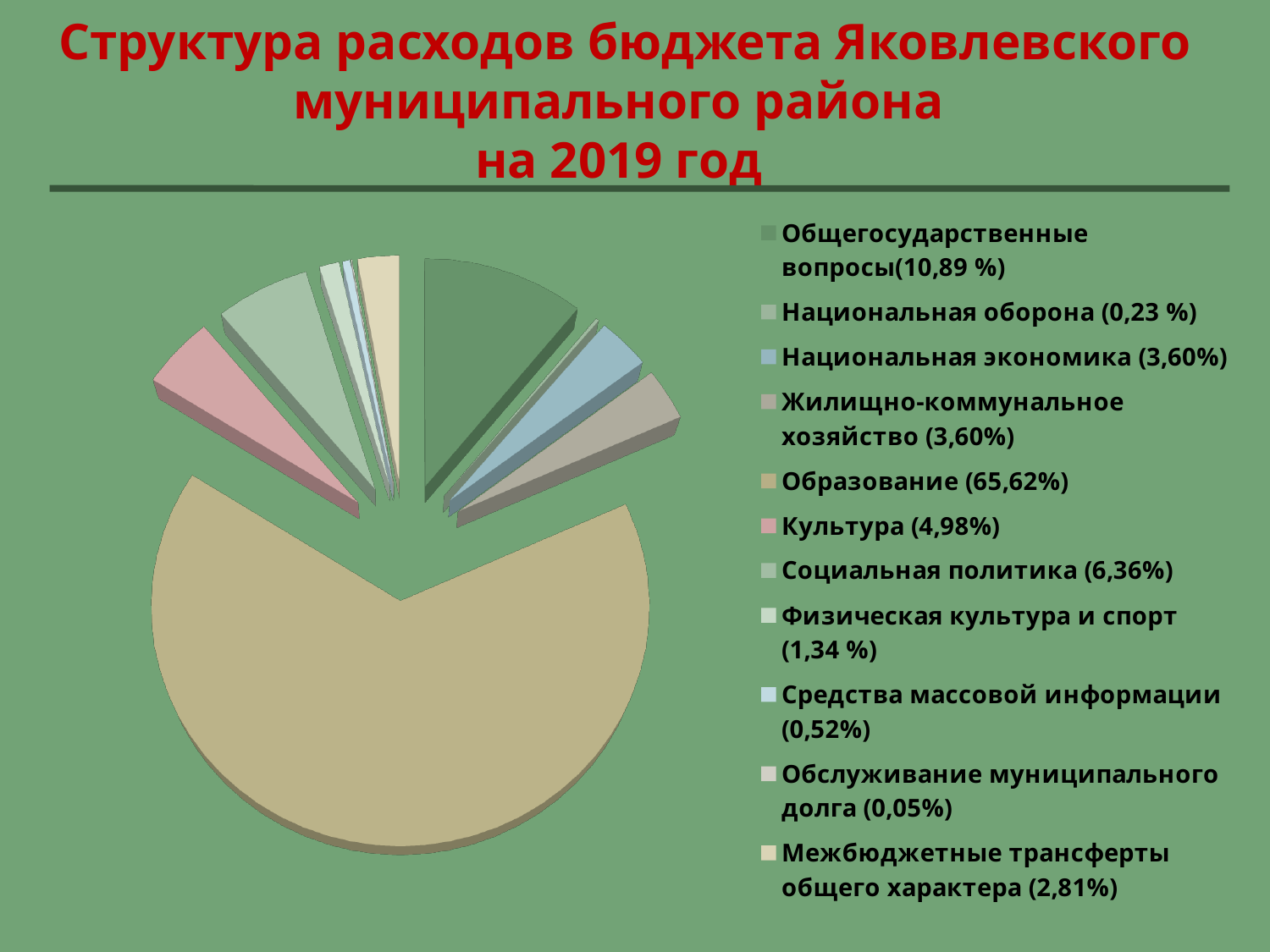
How many categories does the legend of the pie chart list? 11 Which category has the largest share of the budget expenditure? Образование What share is shown for Общегосударственные вопросы? 10,89 % What share of the budget expenditure is Образование? 65,62% What type of chart is shown on the slide? Pie chart Which category has the smallest share of the budget expenditure? Обслуживание муниципального долга What year does the chart title refer to? 2019 Which has a larger share, Культура or Социальная политика? Социальная политика What share is shown for Обслуживание муниципального долга? 0,05% What is the difference in percentage points between Общегосударственные вопросы (10,89 %) and Культура (4,98%)? 5,91 What share is shown for Социальная политика? 6,36% Which two categories have the same share of 3,60%? Национальная экономика and Жилищно-коммунальное хозяйство